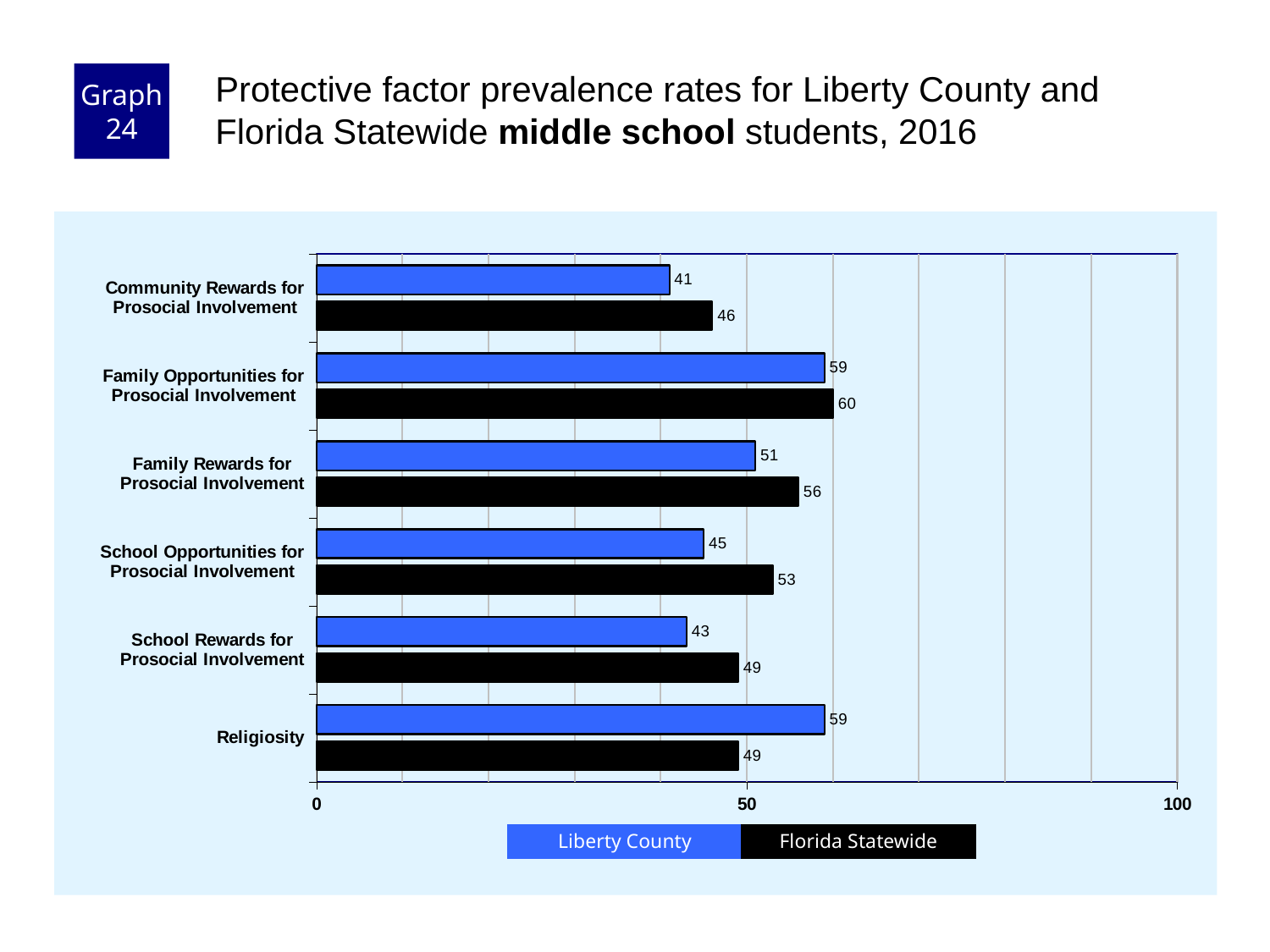
How many series does the legend list? 2 What kind of chart is shown on the slide? bar chart Is the Liberty County value for Family Rewards for Prosocial Involvement greater or less than 50? greater For Religiosity, which is larger: the Liberty County value or the Florida Statewide value? Liberty County Which category has the lowest Liberty County value? Community Rewards for Prosocial Involvement What is the Florida Statewide value for Religiosity? 49 What is the Liberty County value for Community Rewards for Prosocial Involvement? 41 What is the Florida Statewide value for School Opportunities for Prosocial Involvement? 53 What is the difference between the Florida Statewide and Liberty County values for School Opportunities for Prosocial Involvement? 8 Which category has the highest Florida Statewide value? Family Opportunities for Prosocial Involvement How many protective factor categories are shown on the chart? 6 Which colour represents Florida Statewide in the chart? black